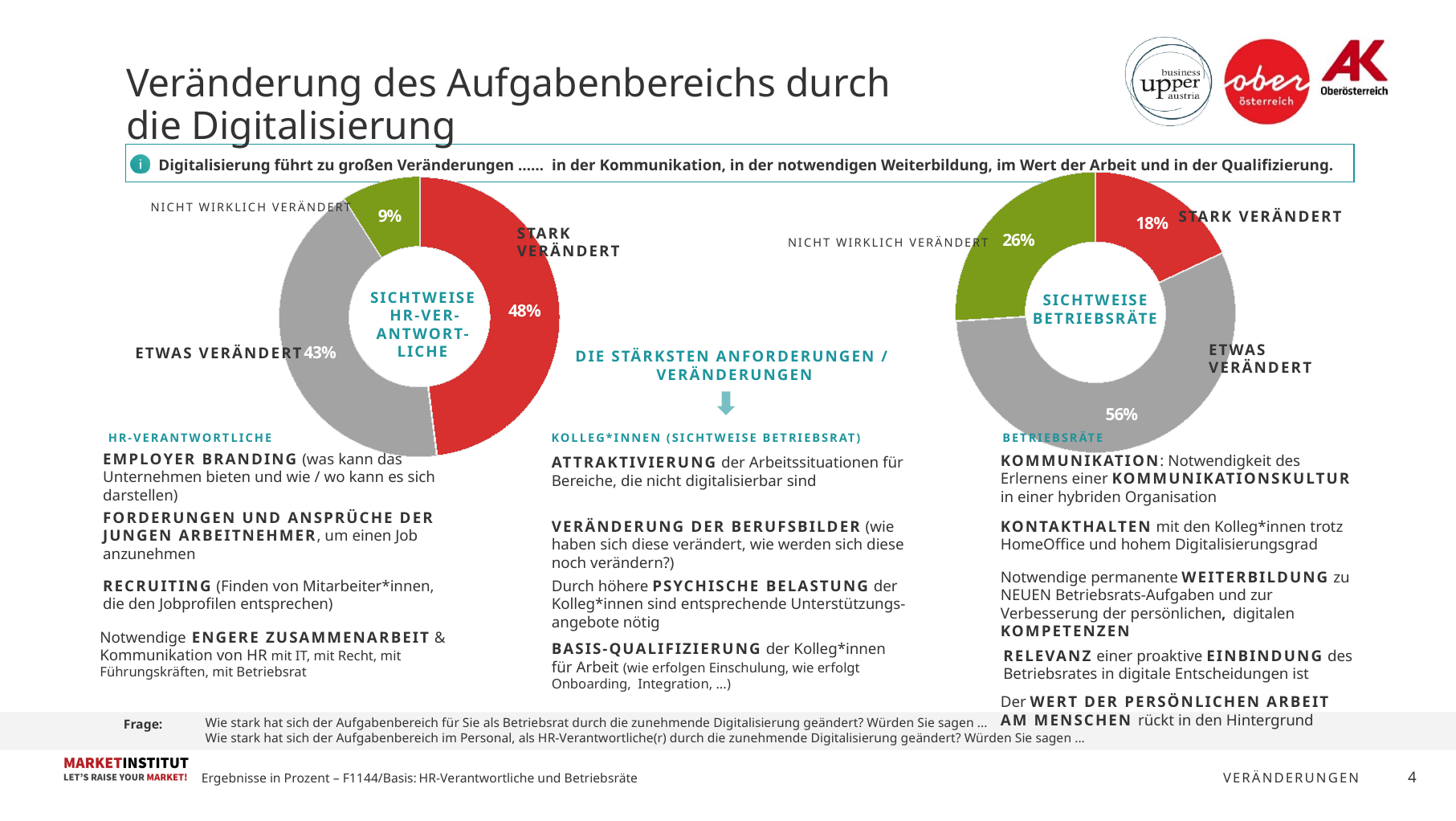
What type of chart is the 'Sichtweise Betriebsräte' chart? Donut (pie) chart In the 'Sichtweise Betriebsräte' chart, which category has the largest share? Etwas verändert In the 'Sichtweise HR-Verantwortliche' chart, which category has the largest share? Stark verändert In the 'Sichtweise Betriebsräte' chart, what percentage is shown for 'Stark verändert'? 18% Which is larger: 'Nicht wirklich verändert' in the 'Sichtweise HR-Verantwortliche' chart or 'Nicht wirklich verändert' in the 'Sichtweise Betriebsräte' chart? Sichtweise Betriebsräte How many categories does the 'Sichtweise HR-Verantwortliche' chart show? 3 In the 'Sichtweise Betriebsräte' chart, which category has the smallest share? Stark verändert What is the difference between 'Etwas verändert' and 'Nicht wirklich verändert' in the 'Sichtweise HR-Verantwortliche' chart? 34% What is the difference between 'Etwas verändert' and 'Stark verändert' in the 'Sichtweise Betriebsräte' chart? 38% In the 'Sichtweise HR-Verantwortliche' chart, what percentage is shown for 'Nicht wirklich verändert'? 9% In the 'Sichtweise Betriebsräte' chart, what percentage is shown for 'Etwas verändert'? 56% In the 'Sichtweise HR-Verantwortliche' chart, what percentage is shown for 'Stark verändert'? 48%